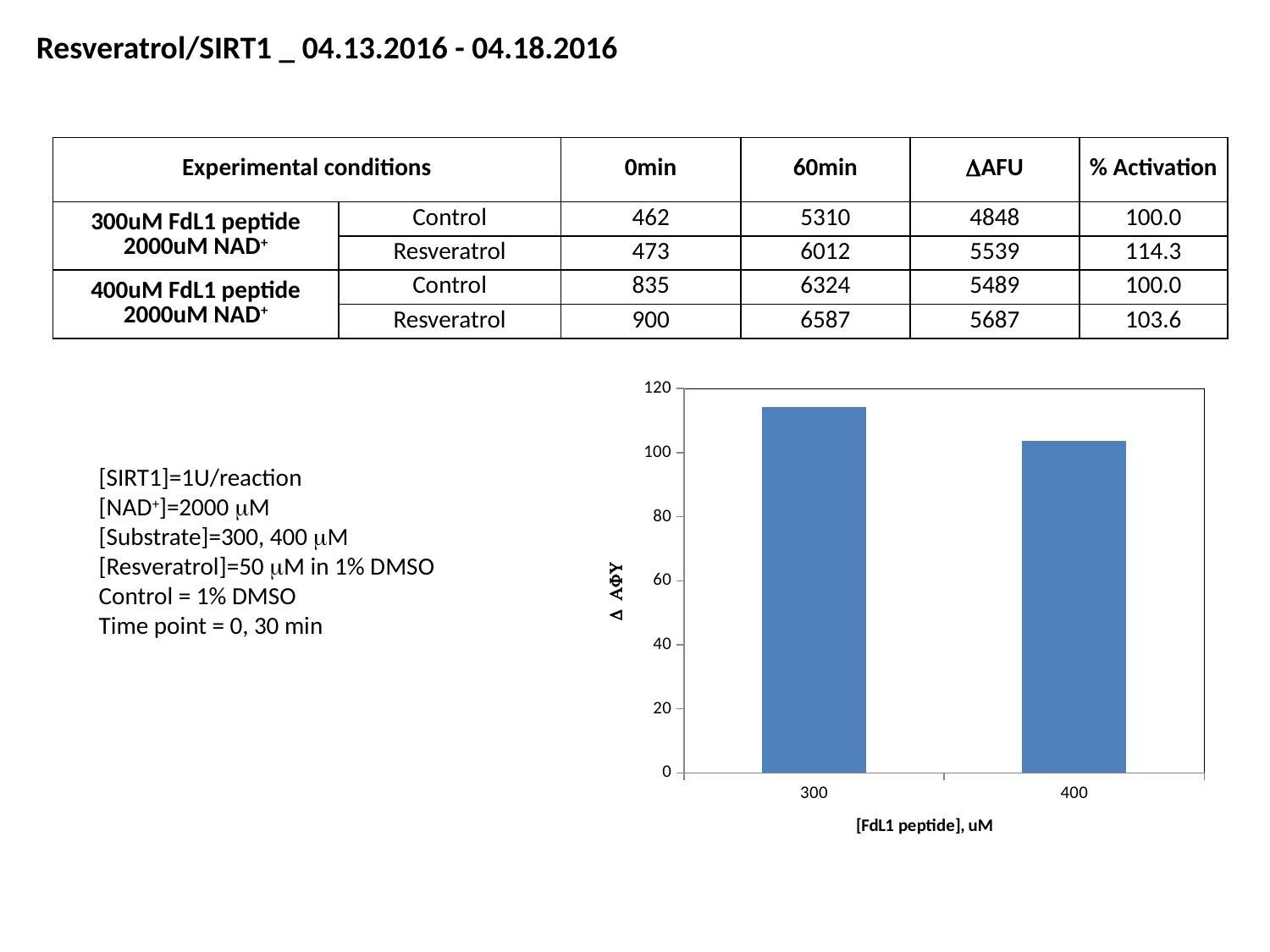
Is the value for 300 in the chart greater or less than 120? less What is the highest tick value shown on the chart's y axis? 120 Do the bar values rise or fall from 300 to 400 along the x axis? fall How many bars are plotted in the chart? 2 Which [FdL1 peptide] concentration has the highest bar in the chart? 300 Which [FdL1 peptide] concentration has the lowest bar in the chart? 400 What kind of chart is shown on the slide? bar chart Is the value for 400 in the chart greater or less than 80? greater Which bar is taller in the chart, 300 or 400? 300 Is the value for 400 in the chart greater or less than 120? less What is the x-axis title of the chart? [FdL1 peptide], uM